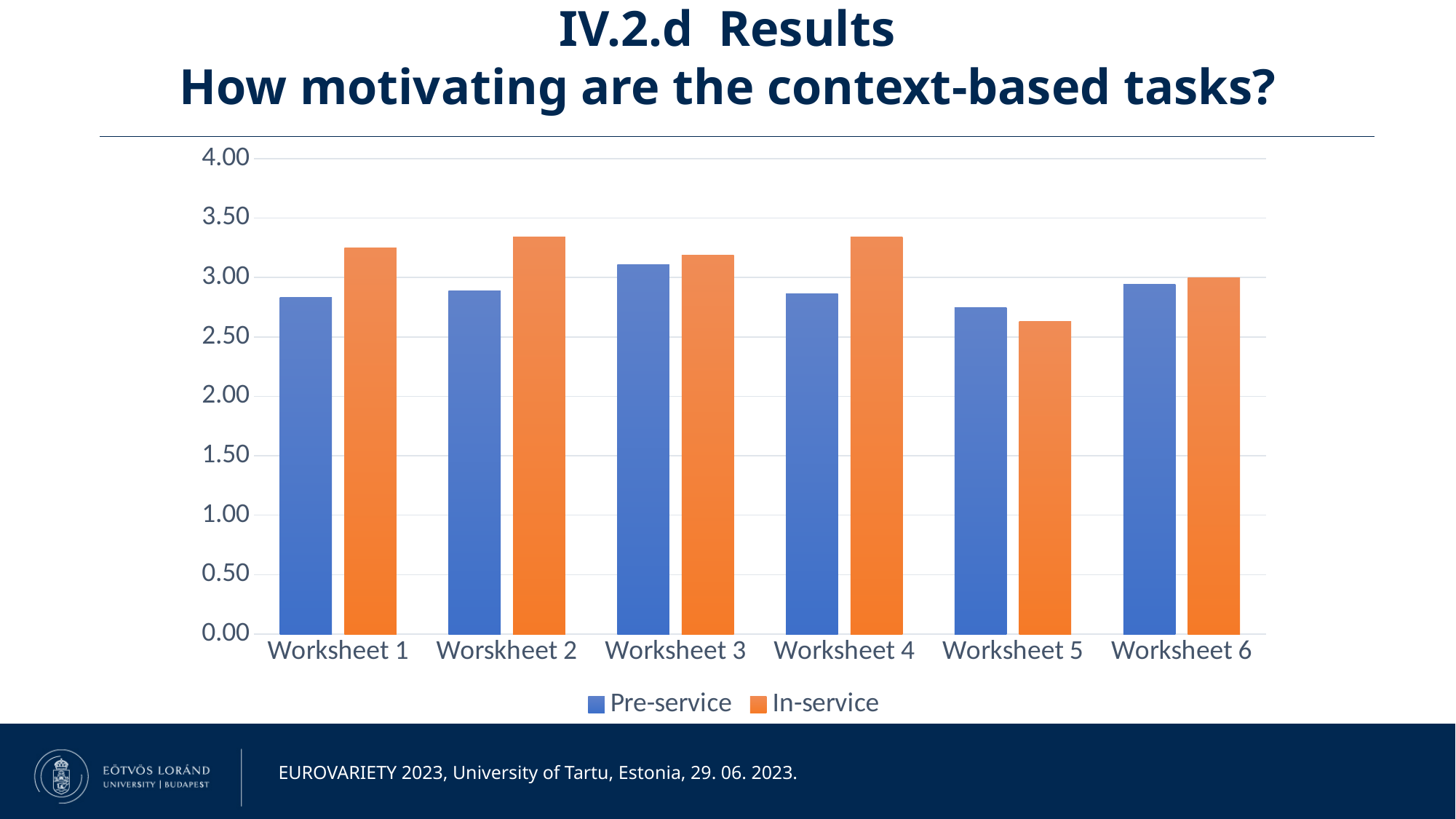
For Worksheet 4, which is larger: the Pre-service value or the In-service value? In-service How many series does the chart's legend list? 2 What kind of chart is shown on the slide? bar chart For Worksheet 5, which is larger: the Pre-service value or the In-service value? Pre-service How many worksheets are shown on the x axis of the chart? 6 Which worksheet has the lowest Pre-service value? Worksheet 5 Is the In-service value for Worksheet 1 greater or less than 3.00? greater Is the Pre-service value for Worksheet 3 greater or less than 3.00? greater Which worksheet has the lowest In-service value? Worksheet 5 Which worksheet has the highest Pre-service value? Worksheet 3 Is the In-service value for Worksheet 5 greater or less than 3.00? less